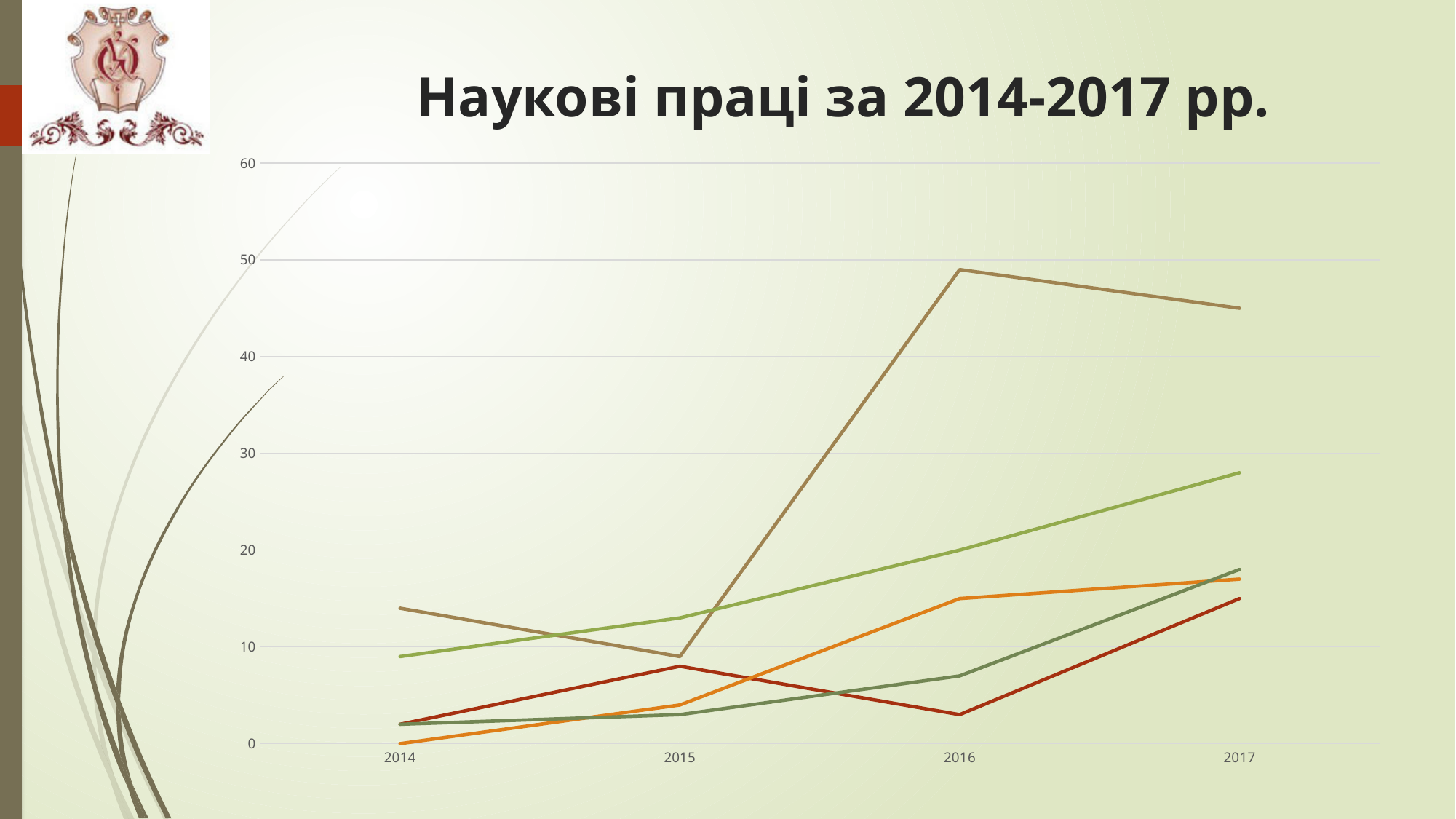
Does the light green line rise or fall from 2014 to 2017? rises Is the value of the light green line in 2017 greater or less than 30? less Is the value of the dark red line in 2016 greater or less than 10? less Which line has the highest value in 2017? the tan/brown line Which line has the lowest value in 2014? the orange line How many years are shown along the x axis of the chart? 4 Is the value of the tan/brown line in 2017 greater or less than 40? greater In 2016, is the tan/brown line higher or lower than the light green line? higher What is the title of the chart? Наукові праці за 2014-2017 рр. How many lines are plotted on the chart? 5 What kind of chart is shown on the slide? line chart